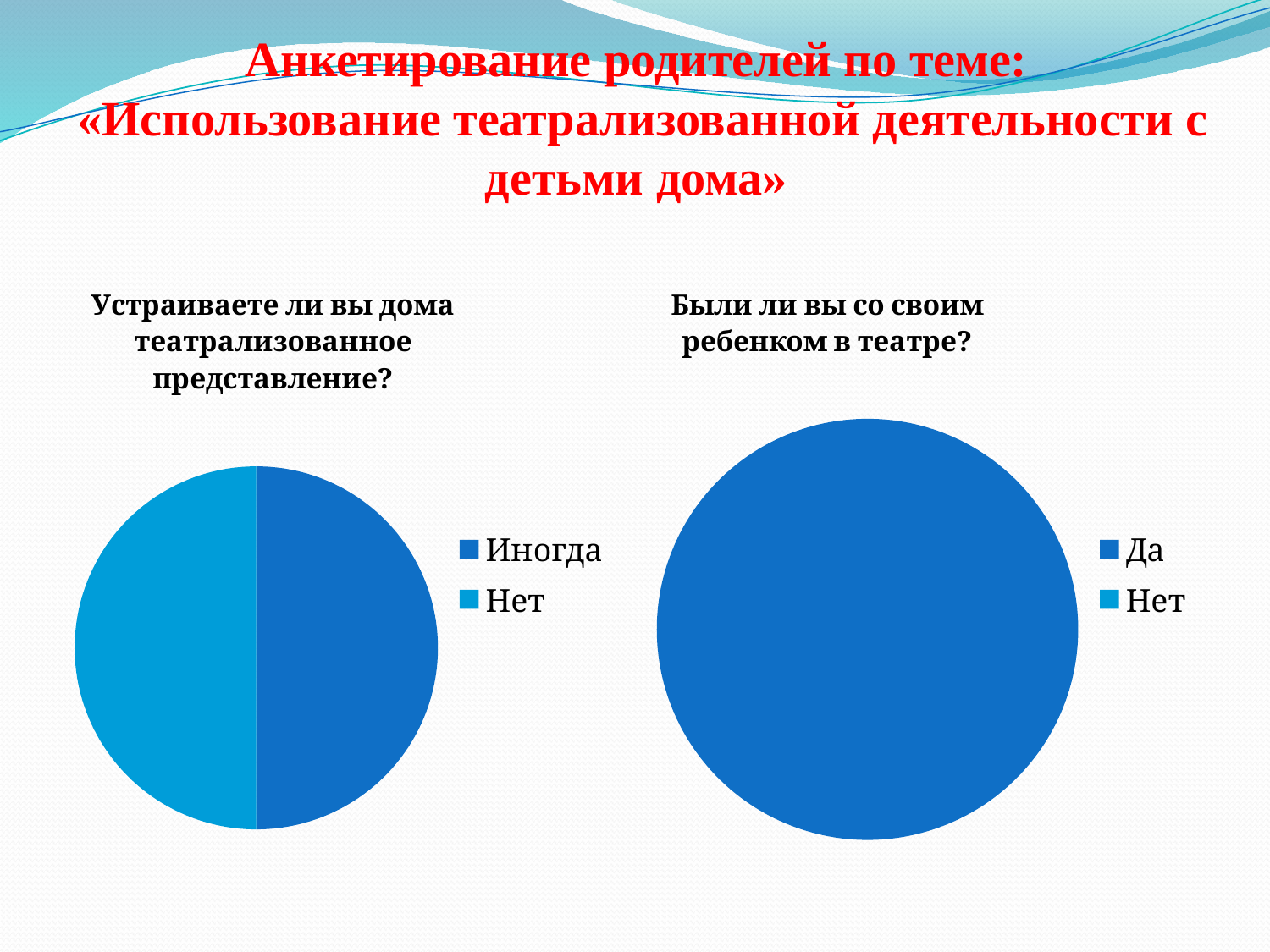
What is the title of the right chart on the slide? Были ли вы со своим ребенком в театре? In the right chart («Были ли вы со своим ребенком в театре?»), which is larger, Да or Нет? Да How many categories does the legend of the right chart («Были ли вы со своим ребенком в театре?») list? 2 What kind of chart is the left chart, titled «Устраиваете ли вы дома театрализованное представление?»? pie chart What are the legend entries of the left chart («Устраиваете ли вы дома театрализованное представление?»)? Иногда, Нет How many charts are shown on the slide? 2 In the right chart («Были ли вы со своим ребенком в театре?»), which category has the largest slice? Да In the right chart («Были ли вы со своим ребенком в театре?»), which category has the smallest slice? Нет How many categories does the legend of the left chart («Устраиваете ли вы дома театрализованное представление?») list? 2 What kind of chart is the right chart, titled «Были ли вы со своим ребенком в театре?»? pie chart